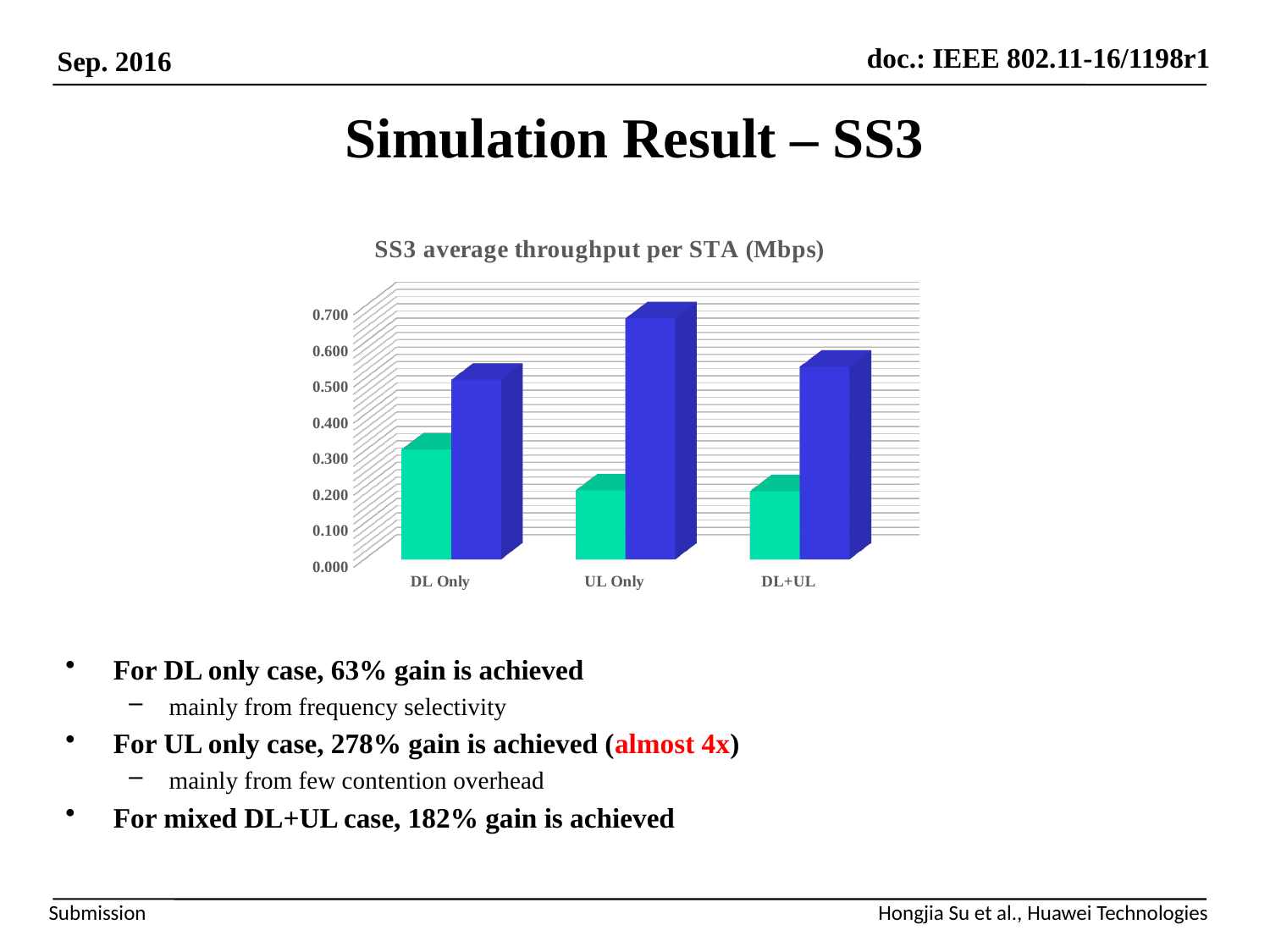
For which category is the blue bar the highest? UL Only In the DL Only category, which bar is larger, the green one or the blue one? the blue one Is the value of the blue bar for UL Only greater or less than 0.600? greater Is the value of the blue bar for DL+UL greater or less than 0.400? greater For which category is the green bar the highest? DL Only How many categories are shown on the x axis of the chart? 3 In the UL Only category, which bar is larger, the green one or the blue one? the blue one What kind of chart is shown on the slide? bar chart What is the title of the chart? SS3 average throughput per STA (Mbps) Is the value of the green bar for DL Only greater or less than 0.200? greater